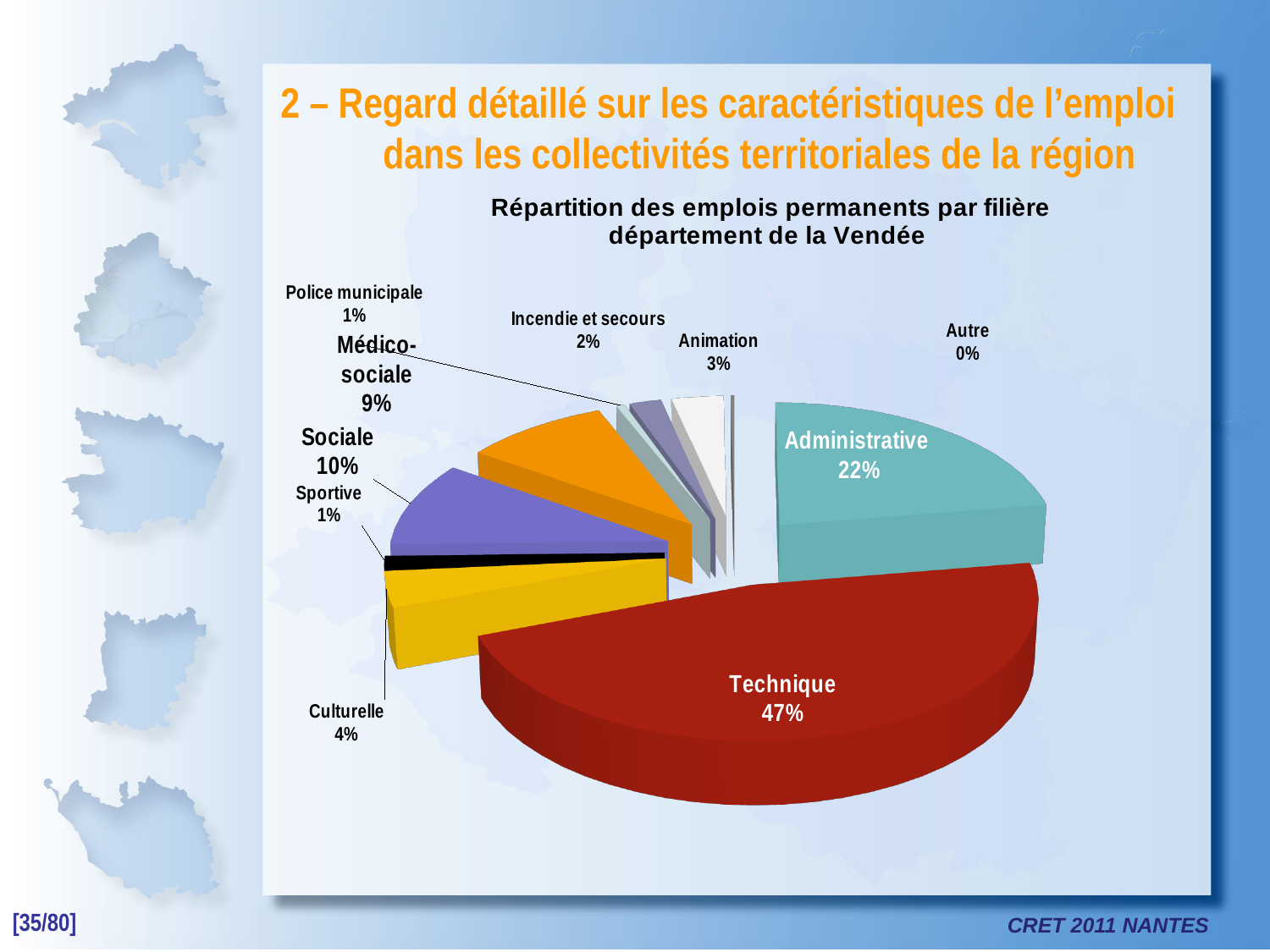
Which filière has the smallest share of the pie? Autre Which is larger, the Sociale slice or the Culturelle slice? Sociale What is the title of the chart? Répartition des emplois permanents par filière département de la Vendée What share of permanent jobs is in the Technique filière? 47% How many categories are shown in the pie chart? 10 What is the difference in percentage points between Technique and Administrative? 25 What is the combined share of Sociale and Médico-sociale? 19% Which filière has the largest share of the pie? Technique What percentage is shown for the Administrative slice? 22% What type of chart is shown on the slide? Pie chart What percentage is shown for Médico-sociale? 9% What percentage is shown for Incendie et secours? 2%